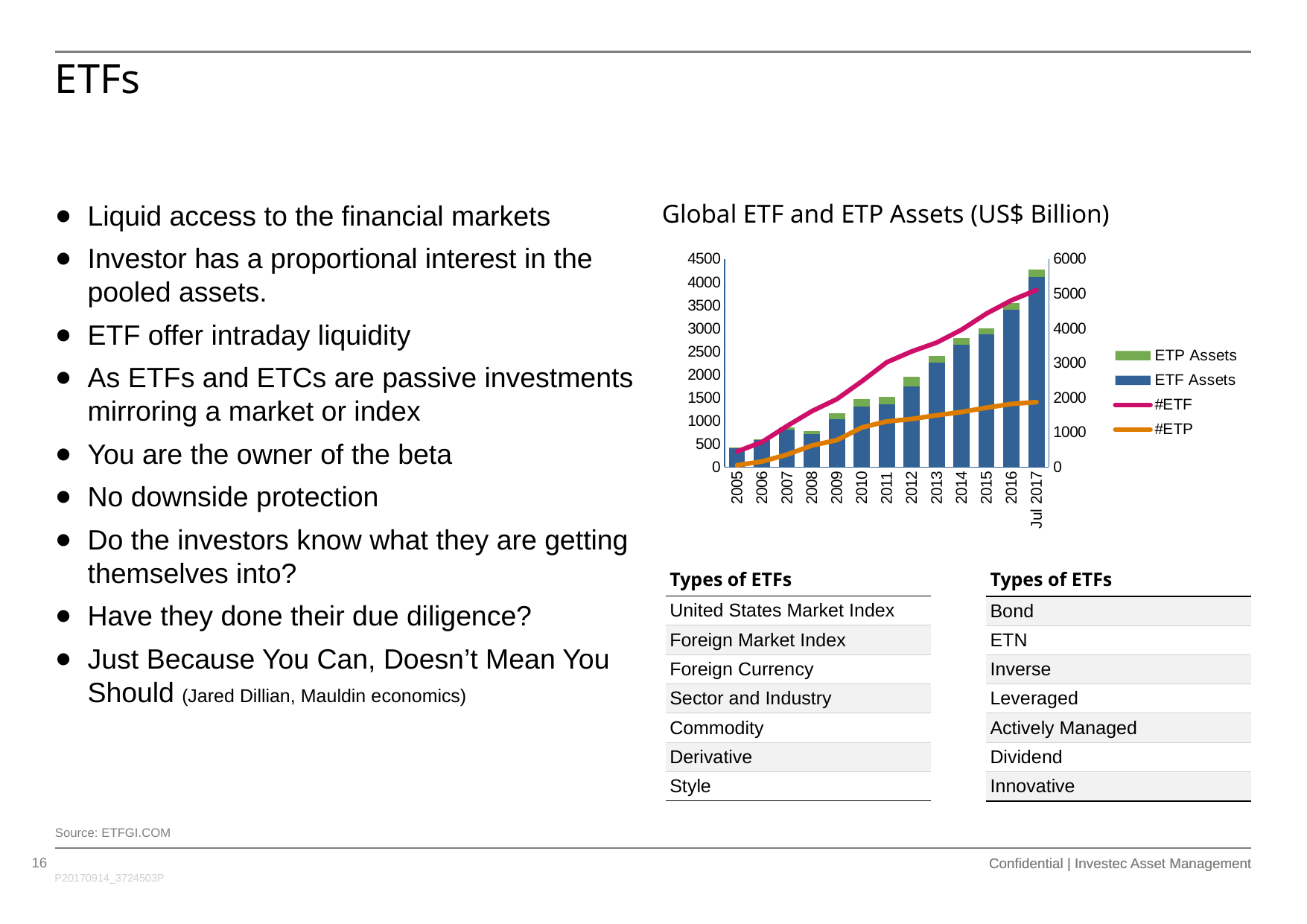
Which period has the highest total ETF and ETP assets? Jul 2017 How many time periods are shown along the x axis of the chart? 13 Which series are listed in the chart's legend? ETP Assets, ETF Assets, #ETF, #ETP Is the total ETF and ETP assets bar for Jul 2017 greater or less than 4000? greater What kind of chart is used to show ETF Assets and ETP Assets? Stacked bar chart (with line series for #ETF and #ETP) Is the ETF Assets value for 2005 greater or less than 500? less Which is larger, the total assets bar for 2007 or for 2008? 2007 Do total ETF and ETP assets generally rise or fall from 2005 to Jul 2017? Rise What is the title of the chart on the slide? Global ETF and ETP Assets (US$ Billion) How many series does the chart's legend list? 4 Is the total ETF and ETP assets bar for 2016 greater or less than 3000? greater Which period has the lowest total ETF and ETP assets? 2005